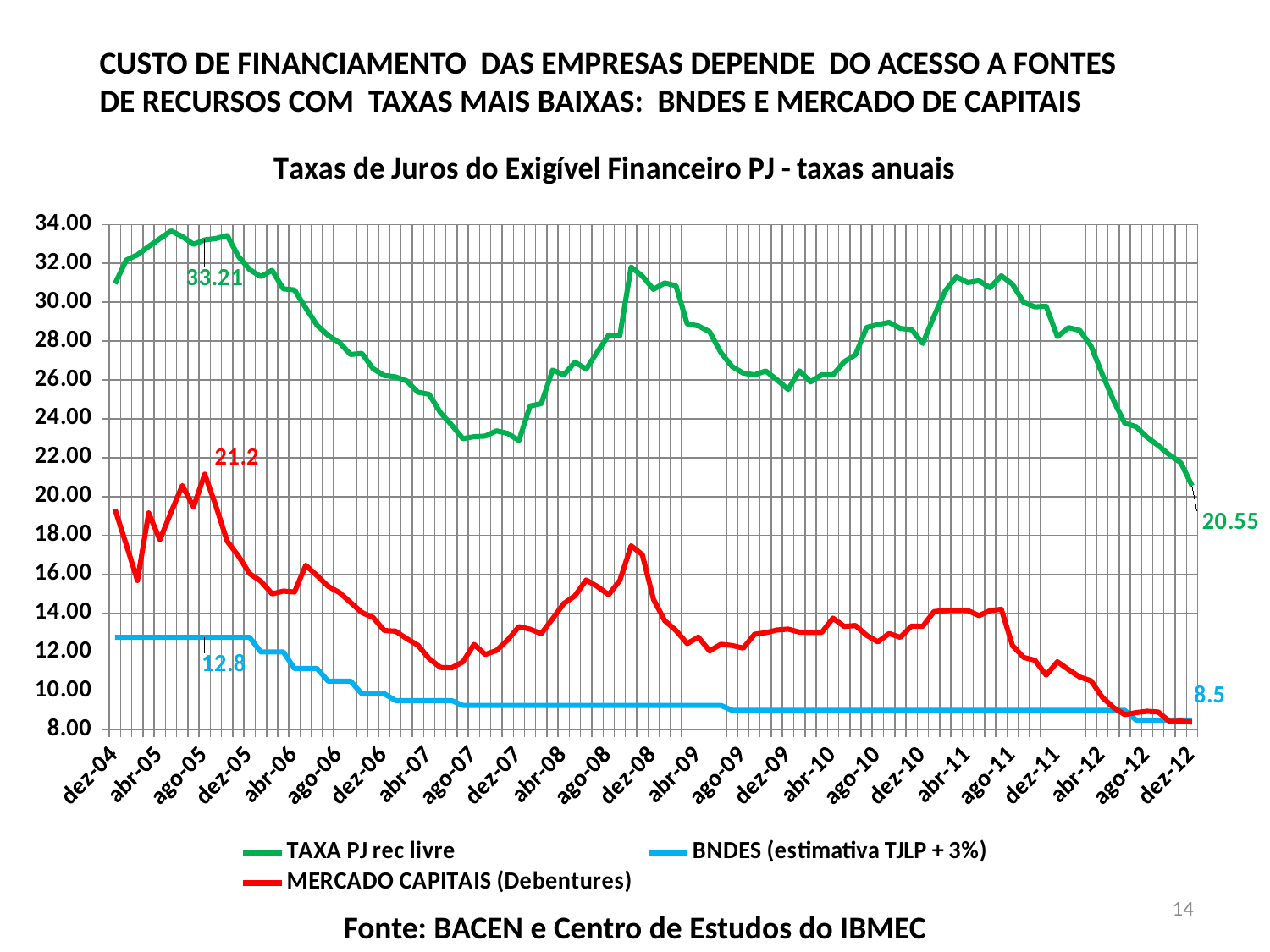
How many series does the legend list? 3 Is the value of MERCADO CAPITAIS (Debentures) at dez-08 greater or less than 16.00? less Does the BNDES (estimativa TJLP + 3%) line rise or fall from dez-04 to dez-12? fall What is the peak value labelled on the MERCADO CAPITAIS (Debentures) line? 21.2 What is the value of BNDES (estimativa TJLP + 3%) at dez-12? 8.5 What is the difference between TAXA PJ rec livre and BNDES (estimativa TJLP + 3%) at dez-12? 12.05 What is the value of TAXA PJ rec livre at dez-12? 20.55 What is the peak value labelled on the TAXA PJ rec livre line? 33.21 At dez-12, which is higher: TAXA PJ rec livre or BNDES (estimativa TJLP + 3%)? TAXA PJ rec livre Is the value of TAXA PJ rec livre at ago-07 greater or less than 24.00? less What kind of chart is shown on the slide? line chart